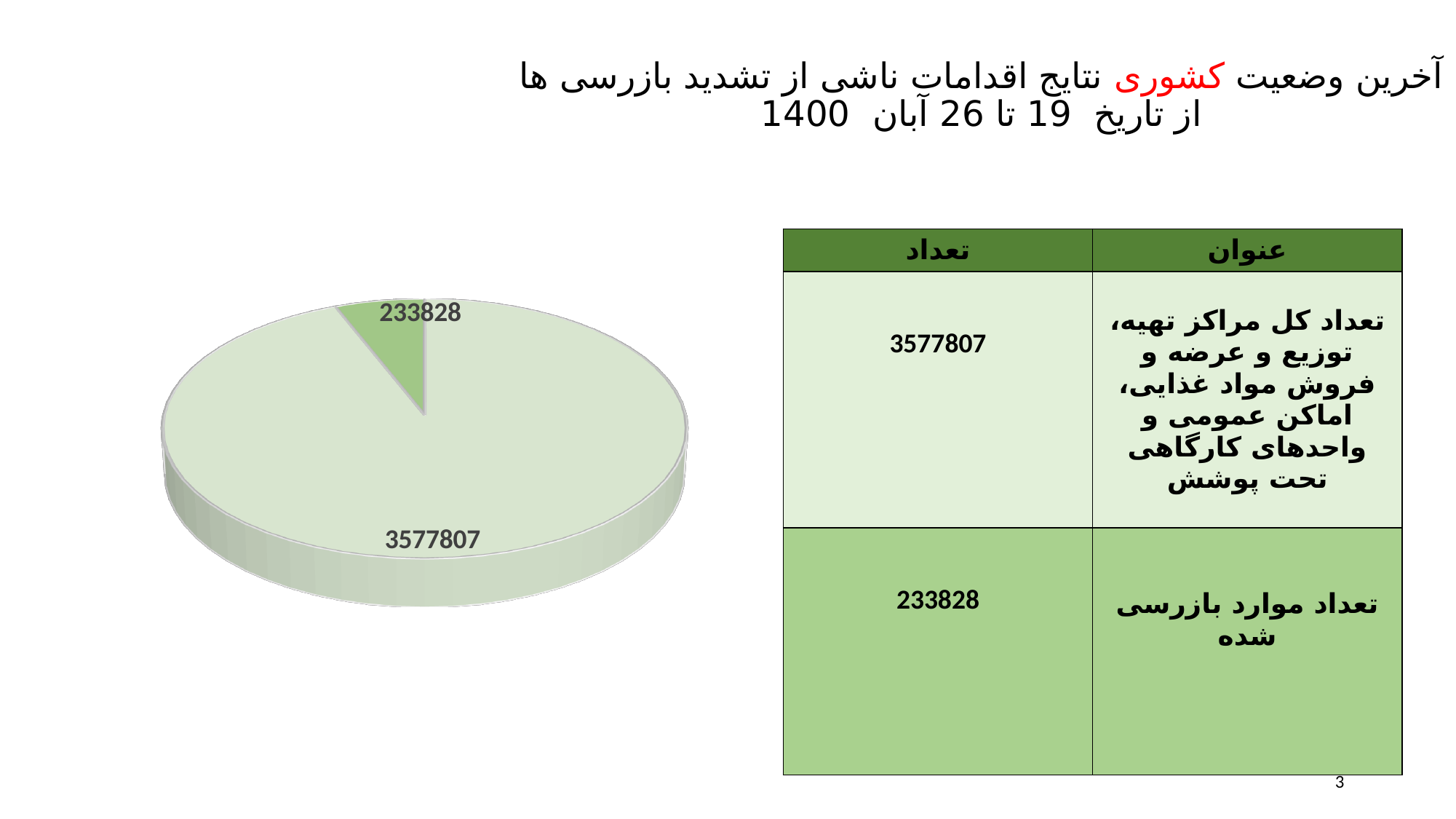
What is the value of the smaller slice of the pie chart? 233828 Which slice of the pie chart is the smallest? 233828 Which is larger in the pie chart: the slice labelled 3577807 or the slice labelled 233828? 3577807 How many slices does the pie chart have? 2 Does the pie chart have a legend? No What kind of chart is shown on the slide? pie chart What is the value of the larger slice of the pie chart? 3577807 Which slice of the pie chart is the largest? 3577807 What is the difference between the two values shown in the pie chart? 3343979 What value does the pie chart show for تعداد موارد بازرسی شده? 233828 What is the total of the two values shown in the pie chart? 3811635